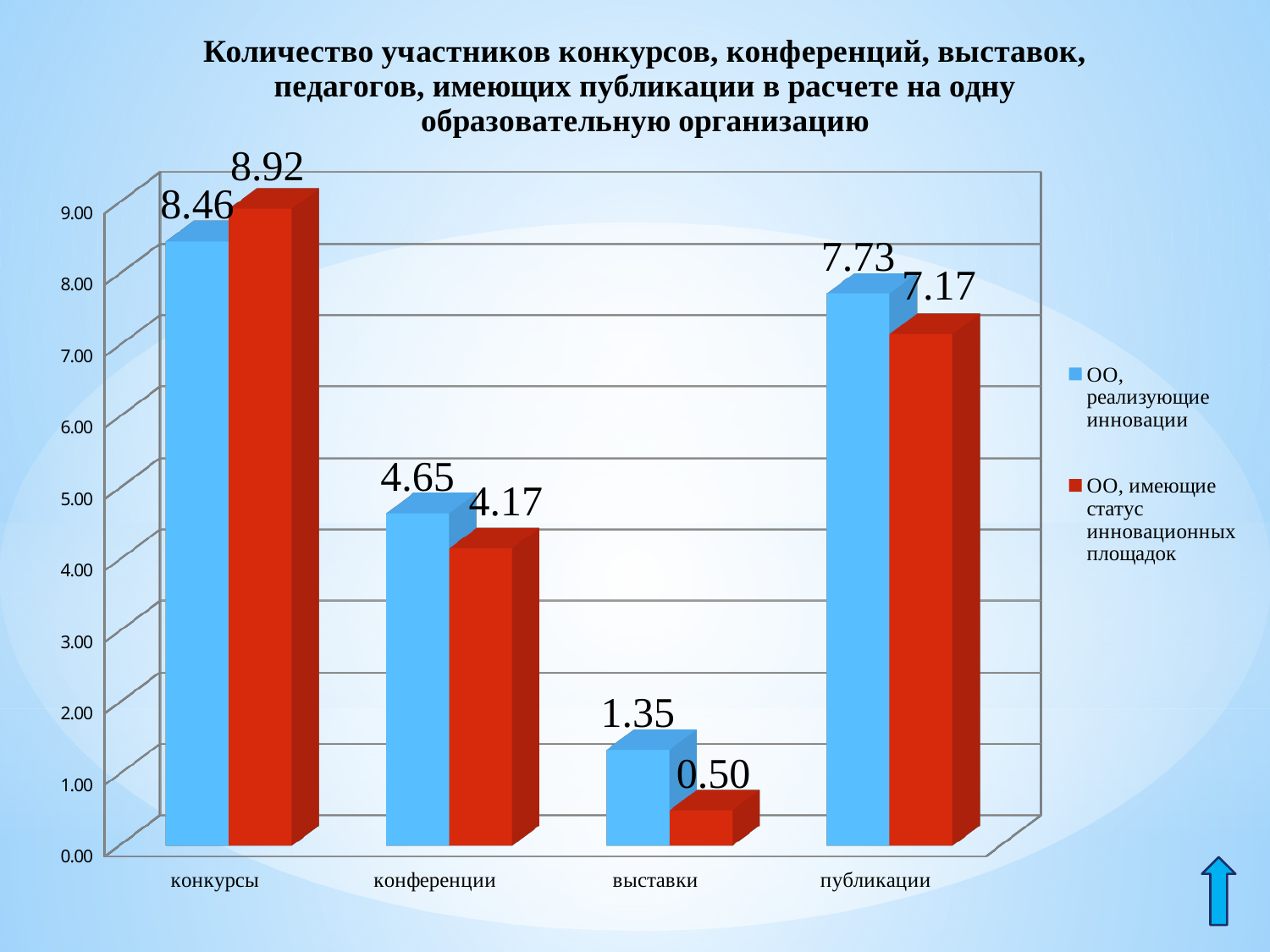
Which category has the lowest value in the series ОО, имеющие статус инновационных площадок? выставки What is the value for конкурсы in the series ОО, реализующие инновации? 8.46 What is the value for конкурсы in the series ОО, имеющие статус инновационных площадок? 8.92 What is the value for выставки in the series ОО, имеющие статус инновационных площадок? 0.50 What is the difference between the two series for конференции? 0.48 What is the value for публикации in the series ОО, реализующие инновации? 7.73 How many series does the legend list? 2 What kind of chart is shown on the slide? bar chart How many categories are shown on the x axis? 4 Which category has the highest value in the series ОО, реализующие инновации? конкурсы What colour represents the series ОО, имеющие статус инновационных площадок? red For публикации, which series has the larger value? ОО, реализующие инновации